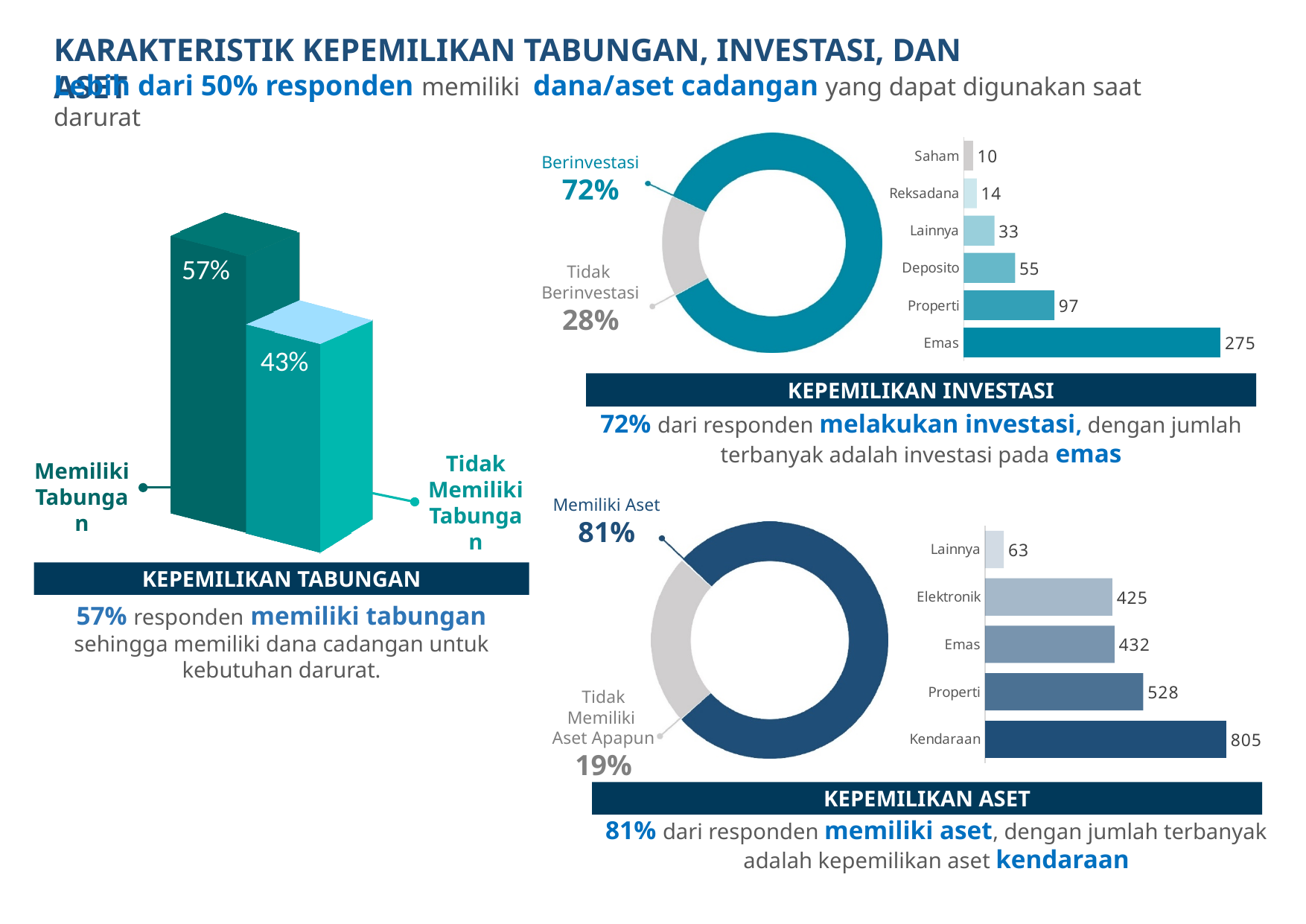
In the Kepemilikan Investasi horizontal bar chart, what is the value for Deposito? 55 In the investment donut chart (Kepemilikan Investasi), what share of respondents are Berinvestasi? 72% In the asset donut chart (Kepemilikan Aset), what share of respondents are Tidak Memiliki Aset Apapun? 19% In the Kepemilikan Aset horizontal bar chart, which is larger, Properti or Elektronik? Properti In the Kepemilikan Aset horizontal bar chart, which category has the lowest value? Lainnya In the Kepemilikan Tabungan bar chart, what percentage of respondents have savings (Memiliki Tabungan)? 57% In the Kepemilikan Investasi horizontal bar chart, which category has the highest value? Emas In the Kepemilikan Tabungan bar chart, what is the value for Tidak Memiliki Tabungan? 43% In the Kepemilikan Investasi horizontal bar chart, what is the difference between Emas and Properti? 178 In the Kepemilikan Investasi horizontal bar chart, how many categories are shown? 6 In the investment donut chart (Kepemilikan Investasi), what share is Tidak Berinvestasi? 28% In the Kepemilikan Tabungan bar chart, what is the difference between Memiliki Tabungan and Tidak Memiliki Tabungan? 14%